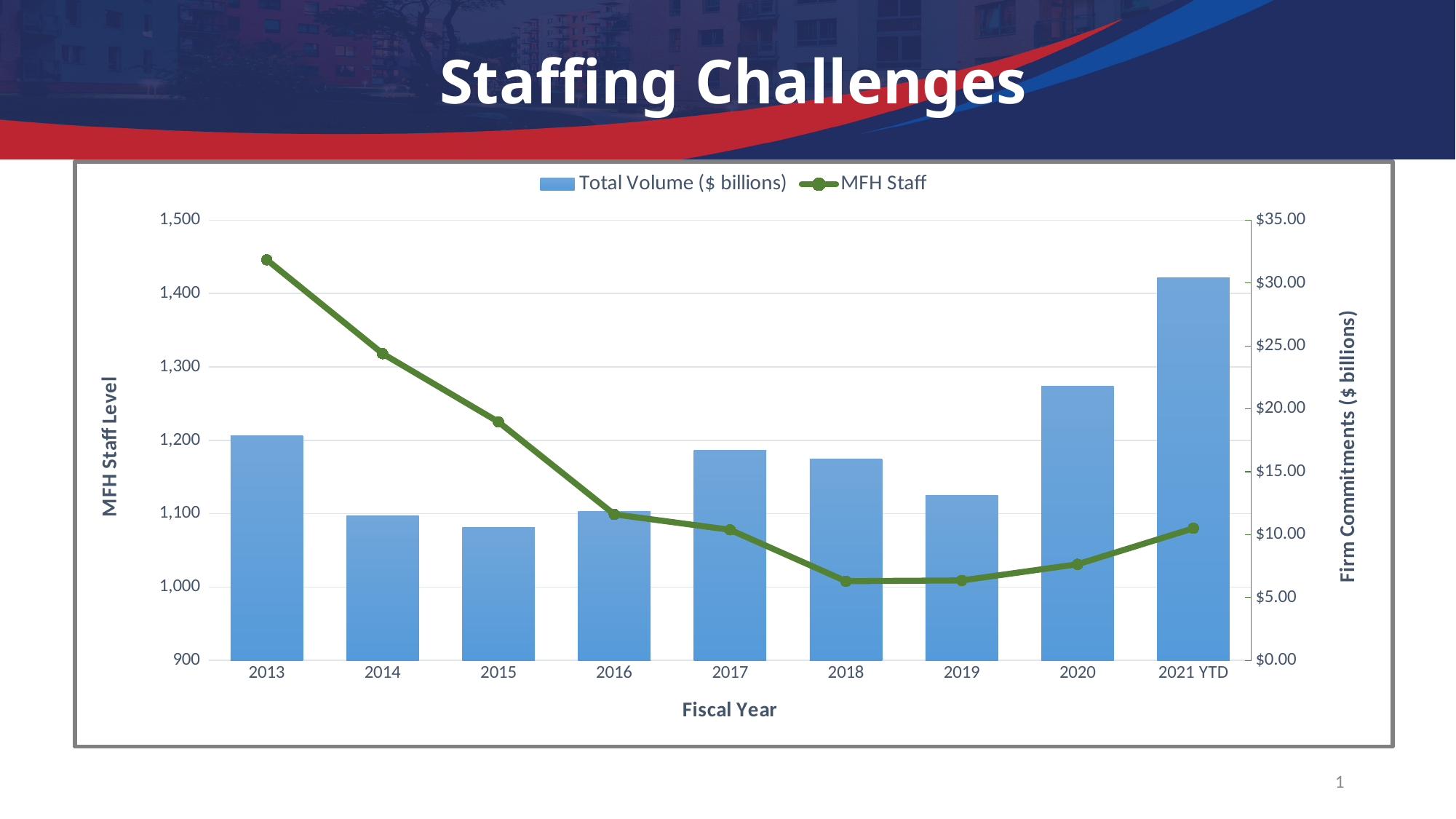
Is the Total Volume for 2020 greater or less than $20.00 billion? greater Is the MFH Staff value for 2013 greater or less than 1,400? greater What kind of chart is shown on the slide? Combined bar and line chart Is the MFH Staff value for 2018 greater or less than 1,100? less Which fiscal year has the highest Total Volume ($ billions) bar? 2021 YTD How many series does the chart legend list? 2 Which has the larger Total Volume, 2020 or 2013? 2020 What is the title of the right-hand vertical axis? Firm Commitments ($ billions) In which fiscal year is the MFH Staff level highest? 2013 Does the MFH Staff line rise or fall from 2013 to 2018? fall How many fiscal years are shown on the x axis? 9